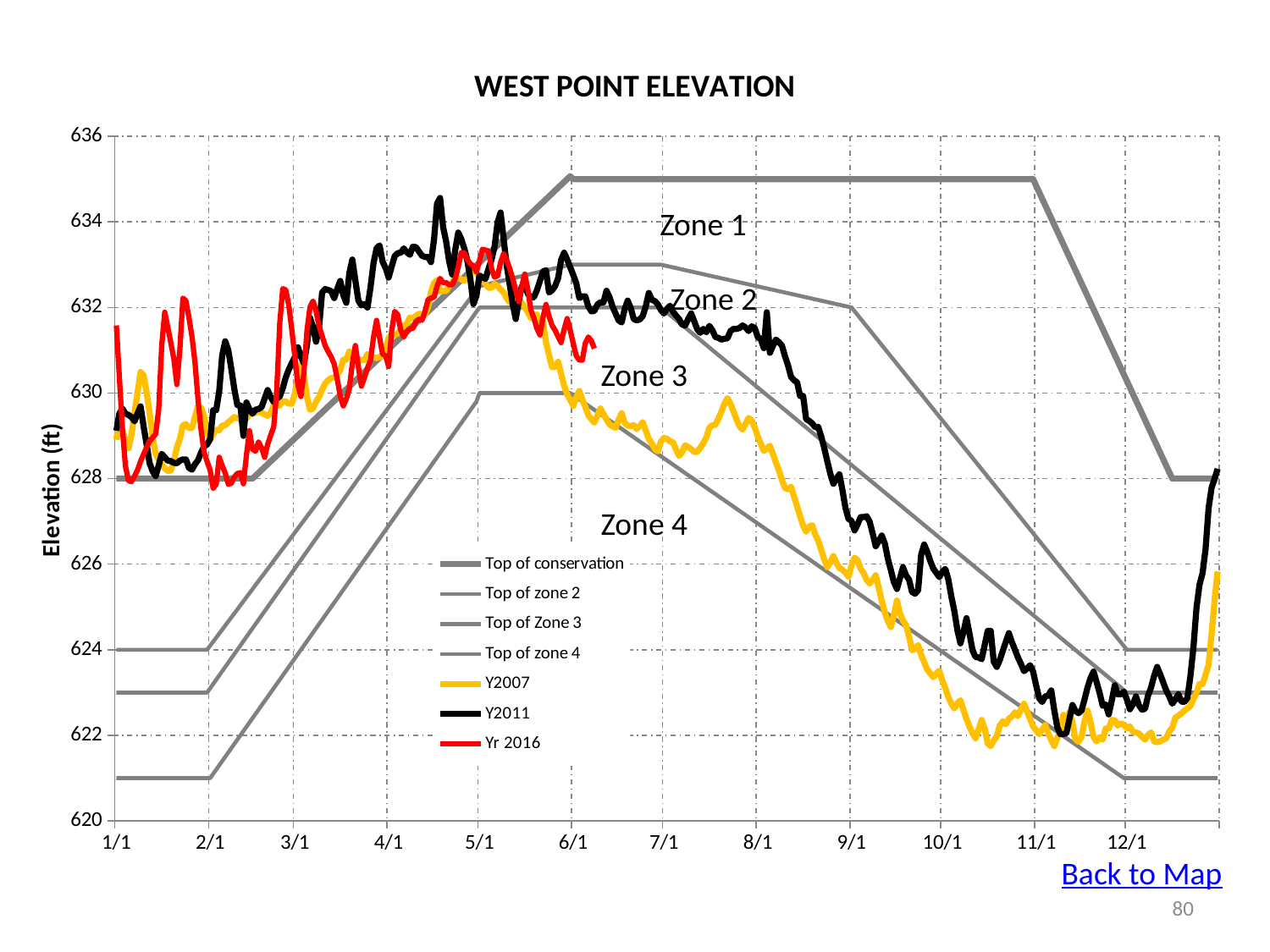
What is the title of the chart? WEST POINT ELEVATION Is the Y2011 value at 8/1 greater or less than 630? greater What elevation does the Top of conservation line hold at 1/1? 628 What elevation does the Top of zone 2 line hold at 1/1? 624 At 8/1, which series is higher, Y2011 or Y2007? Y2011 What elevation does the Top of Zone 3 line hold between 5/1 and 6/1? 632 What elevation does the Top of zone 4 line hold between 5/1 and 6/1? 630 What kind of chart is shown on the slide? line chart Is the Y2007 value at 11/1 greater or less than 624? less Does the Y2007 line rise or fall between 6/1 and 10/1? fall How many series does the legend list? 7 What is the label of the vertical axis? Elevation (ft)